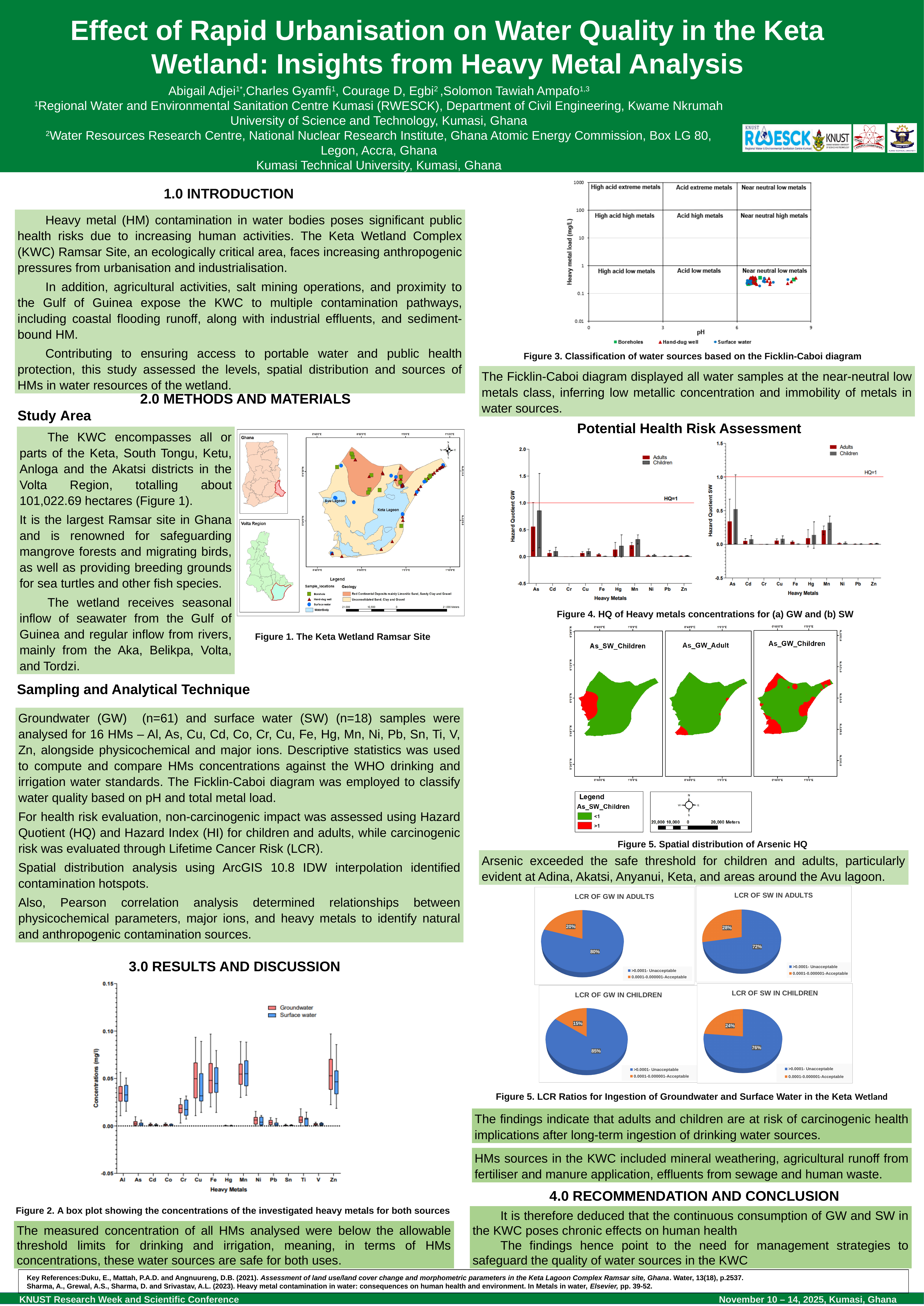
In Figure 4 (a), the Hazard Quotient GW chart, which heavy metal has the highest HQ for children? As What kind of chart is used in Figure 5 to show the LCR ratios? Pie chart How many series does the legend of the box plot in Figure 2 list? 2 In the pie chart titled "LCR OF SW IN ADULTS", what percentage is labelled for the 0.0001-0.000001 (Acceptable) slice? 28% How many heavy metals are shown on the x axis of the box plot in Figure 2? 15 How many water source types does the legend of the Ficklin-Caboi diagram in Figure 3 list? 3 Which pie chart shows a larger Unacceptable share: "LCR OF GW IN ADULTS" or "LCR OF SW IN ADULTS"? LCR OF GW IN ADULTS In the pie chart titled "LCR OF GW IN ADULTS", what percentage is labelled for the >0.0001 (Unacceptable) slice? 80% In Figure 4 (a), the Hazard Quotient GW chart, is the HQ value for As for children greater or less than 0.5? greater In the pie chart titled "LCR OF GW IN CHILDREN", what percentage is labelled for the >0.0001 (Unacceptable) slice? 85% Comparing the "LCR OF GW IN CHILDREN" and "LCR OF SW IN CHILDREN" pie charts, by how many percentage points does the Unacceptable share in groundwater exceed that in surface water? 9 percentage points In the pie chart titled "LCR OF SW IN CHILDREN", what percentage is labelled for the 0.0001-0.000001 (Acceptable) slice? 24%